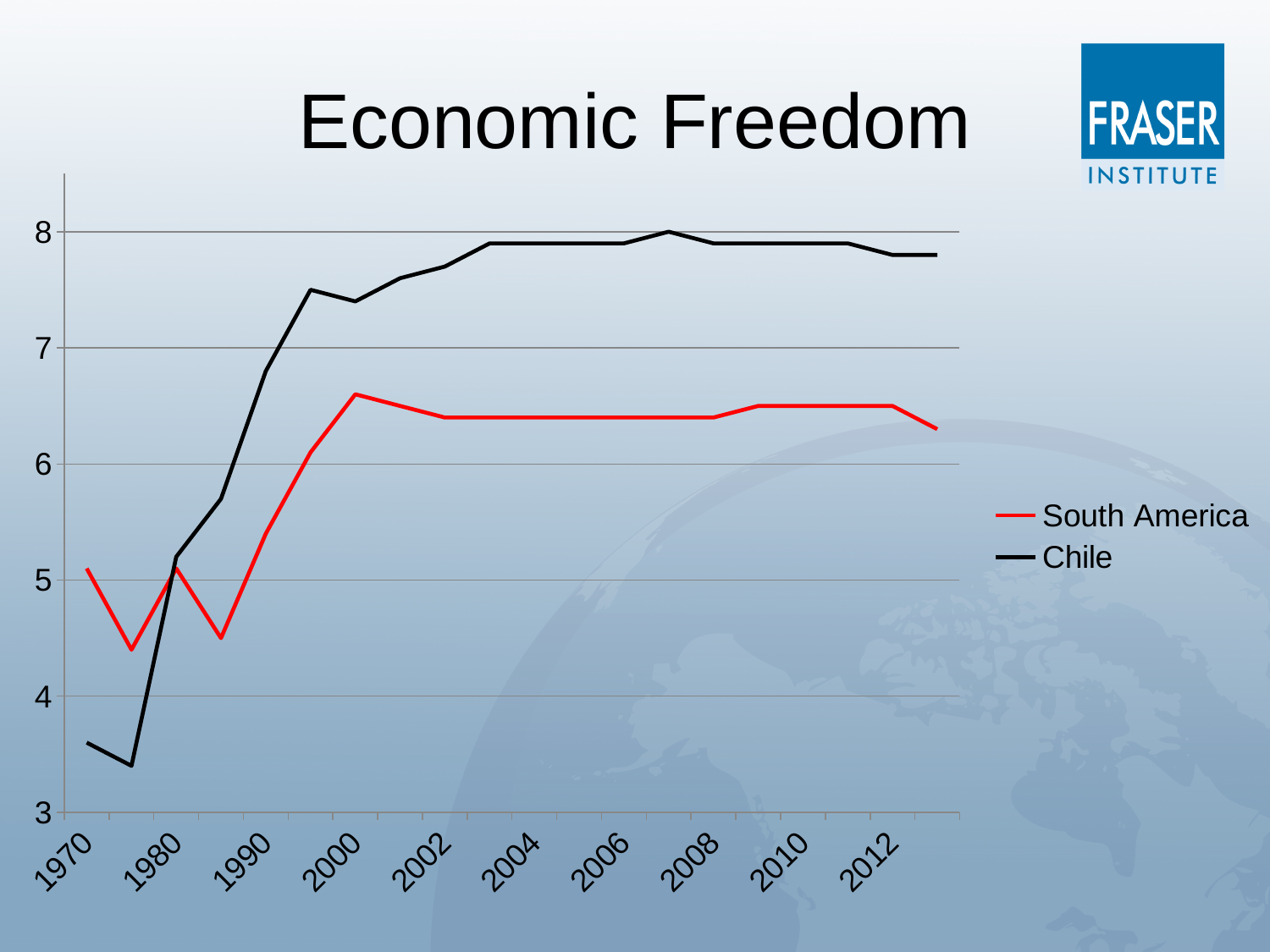
Is the value for South America in 2000 greater or less than 6? greater What is the title of the chart? Economic Freedom In 2010, which series has the higher value, Chile or South America? Chile How many series does the legend list? 2 Is the value for Chile in 2000 greater or less than 7? greater Which series is drawn in black? Chile In 1970, which series has the higher value, Chile or South America? South America Is the value for Chile in 2012 greater or less than 7? greater Does the Chile line rise or fall between 1970 and 2000? Rise What kind of chart is shown on the slide? Line chart